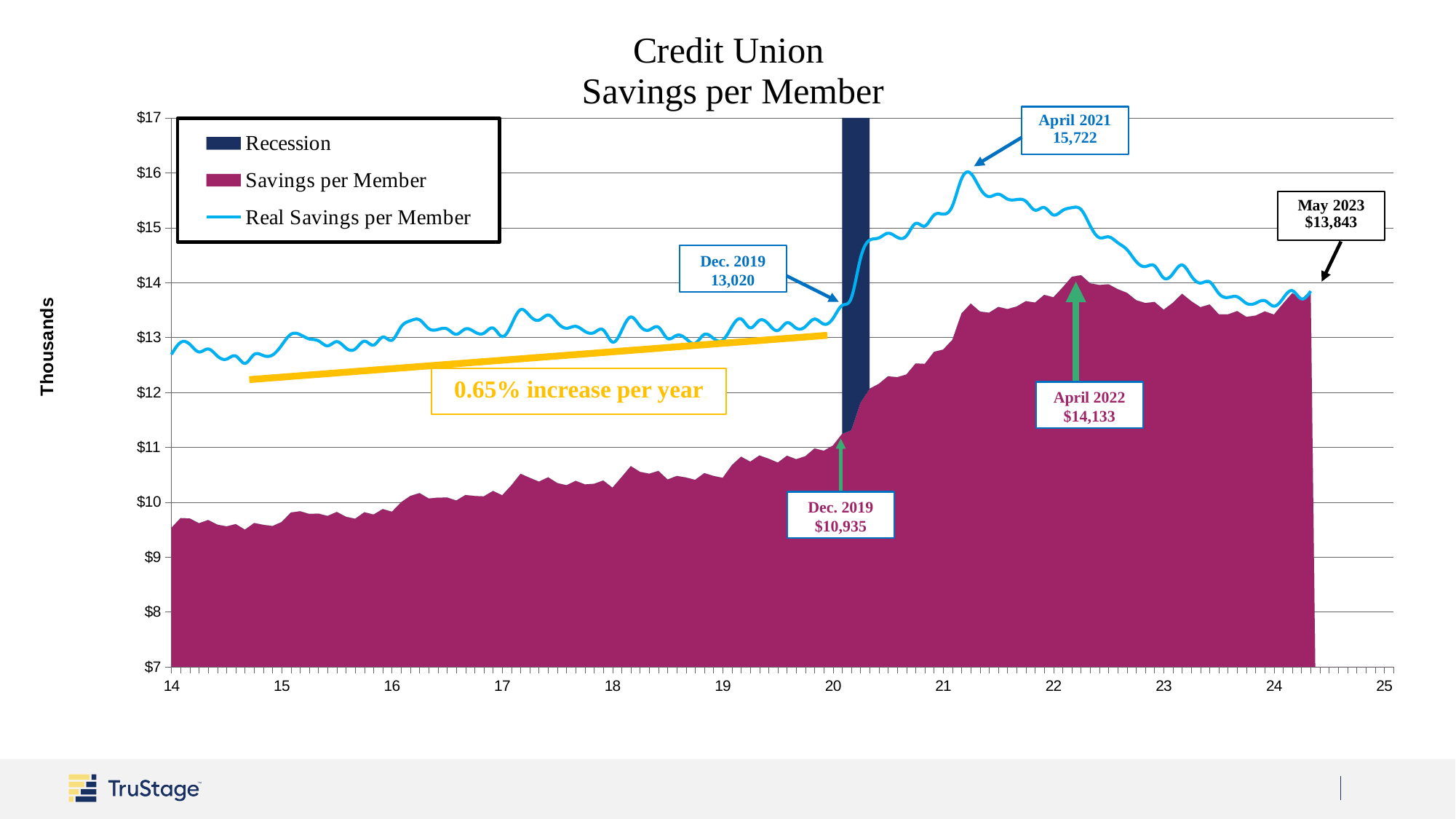
In Dec. 2019, which was larger: Savings per Member or Real Savings per Member? Real Savings per Member What value is labelled for May 2023? $13,843 What is the difference between the labelled Real Savings per Member values for April 2021 and Dec. 2019? 2,702 What is the Savings per Member value labelled for April 2022? $14,133 What is the Real Savings per Member value labelled for April 2021? 15,722 How many entries does the legend list? 3 By how much did Savings per Member increase from Dec. 2019 to April 2022, according to the labels? $3,198 At the start of 2014, is the Savings per Member value greater or less than $10? less What annual rate of increase is written on the yellow trend line? 0.65% increase per year What is the Savings per Member value labelled for Dec. 2019? $10,935 What kind of chart is shown on the slide? area chart with a line What is the Real Savings per Member value labelled for Dec. 2019? 13,020